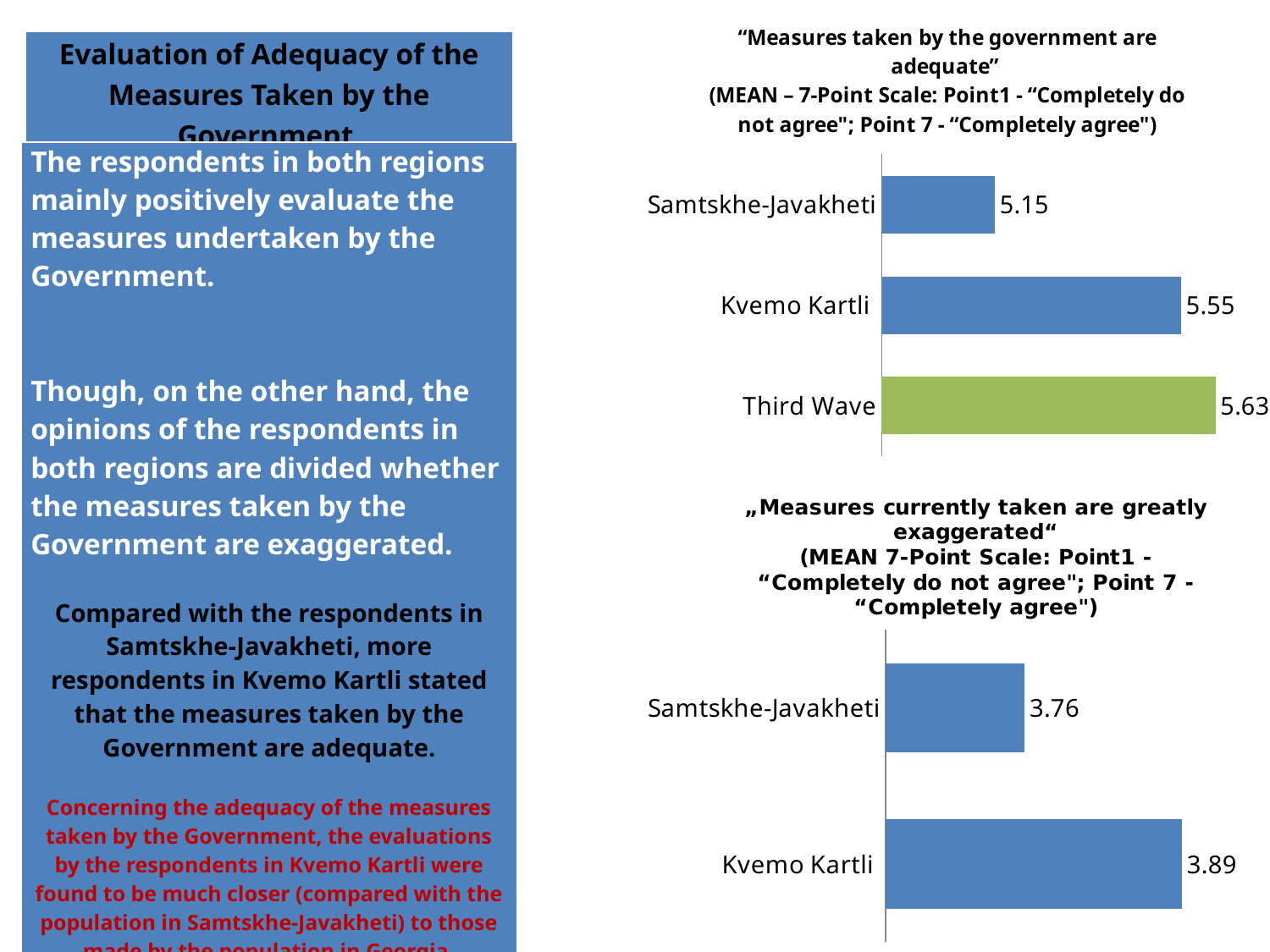
In the bottom chart ("Measures currently taken are greatly exaggerated"), what is the value for Samtskhe-Javakheti? 3.76 What type of chart is the bottom chart ("Measures currently taken are greatly exaggerated")? Bar chart In the top chart ("Measures taken by the government are adequate"), what is the value for Kvemo Kartli? 5.55 In the top chart ("Measures taken by the government are adequate"), which category has the lowest value? Samtskhe-Javakheti In the top chart ("Measures taken by the government are adequate"), what is the value for Third Wave? 5.63 In the bottom chart ("Measures currently taken are greatly exaggerated"), what is the value for Kvemo Kartli? 3.89 In the top chart ("Measures taken by the government are adequate"), what is the value for Samtskhe-Javakheti? 5.15 In the bottom chart ("Measures currently taken are greatly exaggerated"), what is the difference between the values for Kvemo Kartli and Samtskhe-Javakheti? 0.13 In the bottom chart ("Measures currently taken are greatly exaggerated"), which region has the larger value, Samtskhe-Javakheti or Kvemo Kartli? Kvemo Kartli In the top chart ("Measures taken by the government are adequate"), how many categories are shown? 3 In the top chart ("Measures taken by the government are adequate"), which category has the highest value? Third Wave In the top chart ("Measures taken by the government are adequate"), what is the difference between the values for Kvemo Kartli and Samtskhe-Javakheti? 0.40